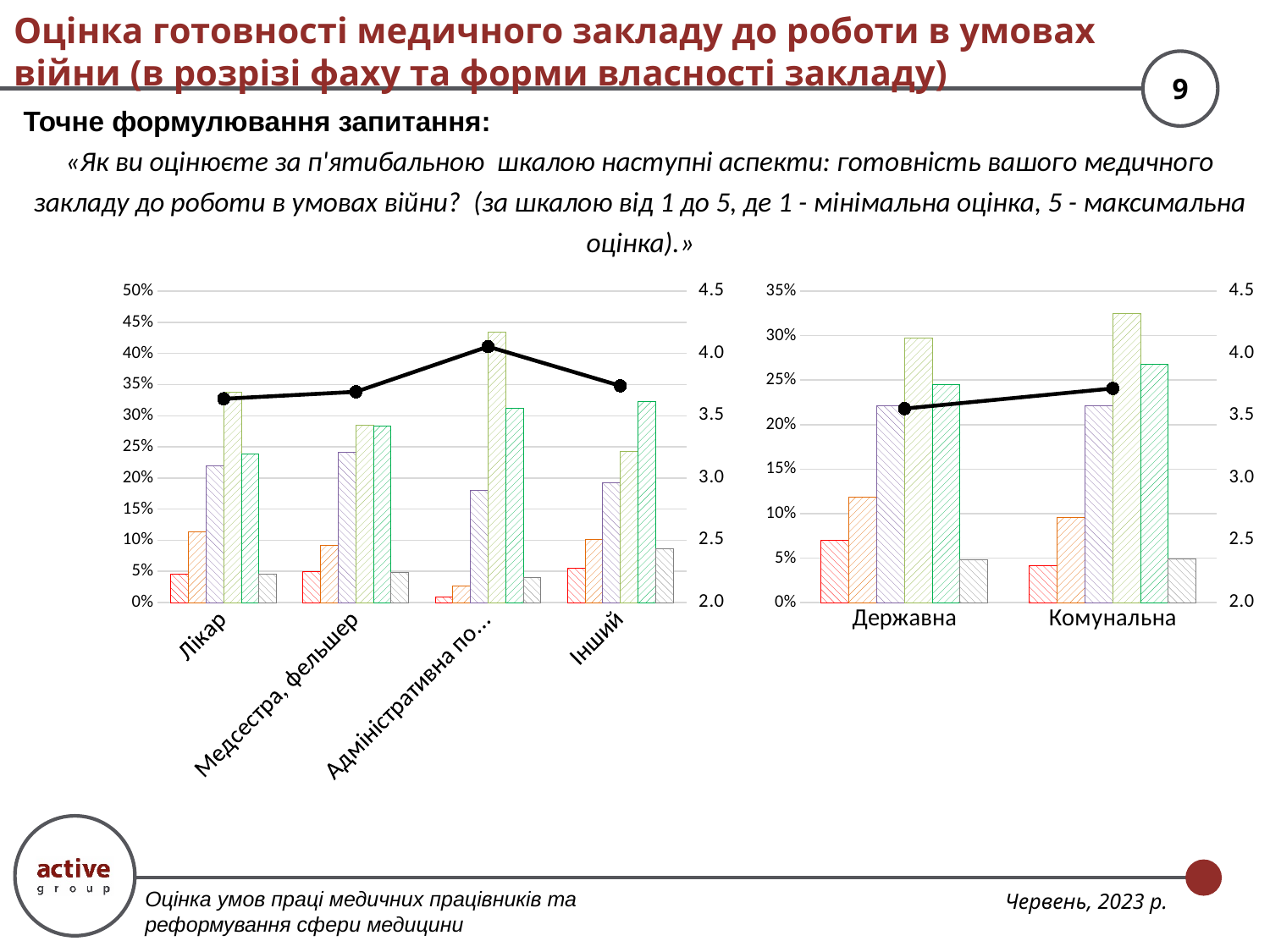
On the left chart, is the black line value for Лікар greater or less than 4.0? less On the right chart, is the black line value for Державна greater or less than 4.0? less On the right chart, is the tallest bar for Комунальна greater or less than 30%? greater On the right chart, how many categories are shown on the x axis? 2 On the left chart, what is the maximum value shown on the right-hand (secondary) axis? 4.5 On the right chart, does the black line rise or fall from Державна to Комунальна? rises On the left chart, how many categories are shown on the x axis? 4 On the right chart, which category has the higher value on the black line, Державна or Комунальна? Комунальна What kind of chart is the right chart? combination bar and line chart On the left chart, which category has the highest value on the black line? Адміністративна по...